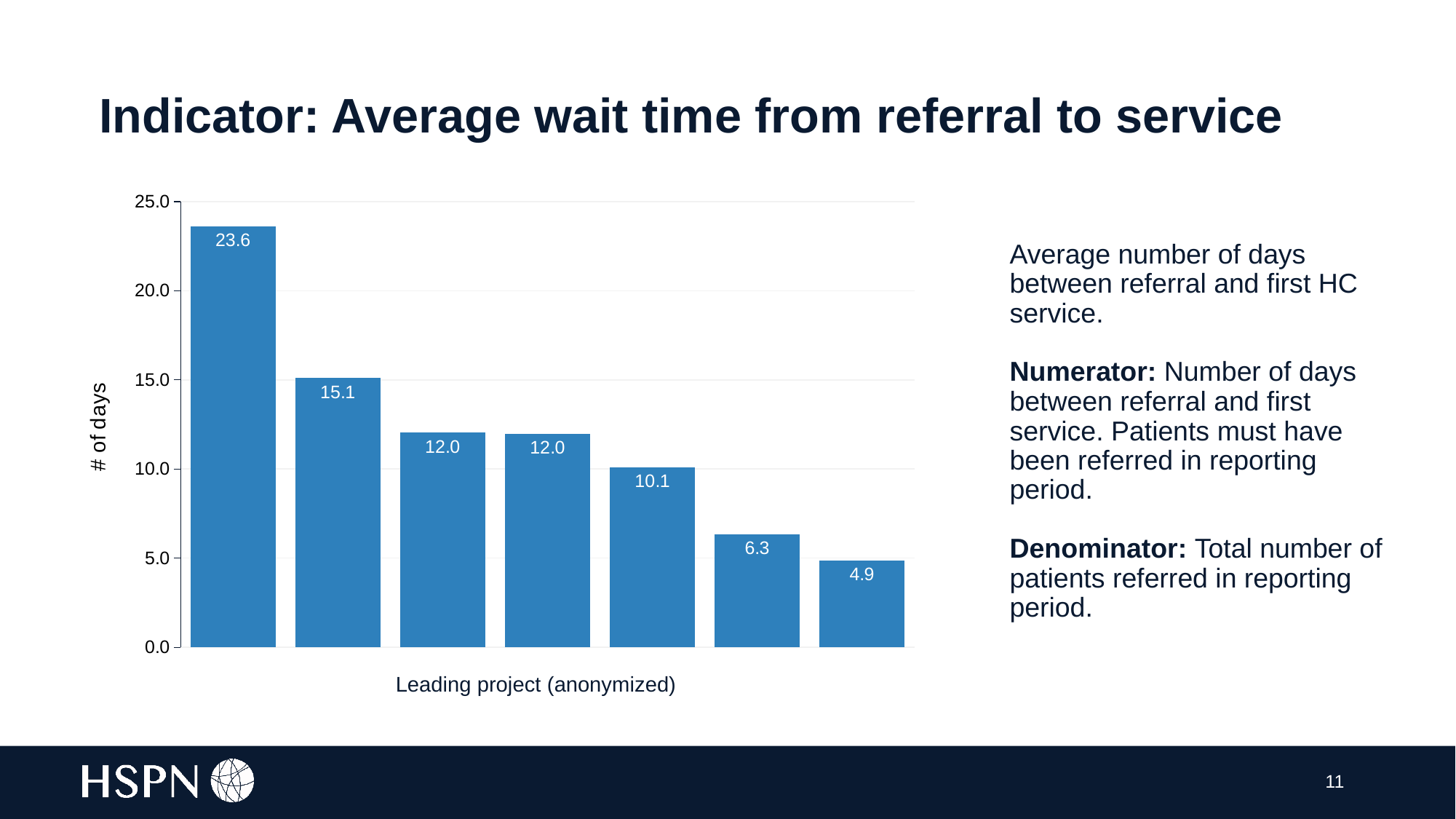
What is the difference between the second bar (15.1) and the third bar (12.0)? 3.1 What is the value shown on the second bar from the left? 15.1 What is the value shown on the fifth bar from the left? 10.1 What type of chart is shown on the slide? Bar chart What is the difference between the leftmost bar and the rightmost bar? 18.7 Is the value of the leftmost bar greater or less than 20.0? greater Do the bar values rise or fall from left to right across the chart? Fall What is the value shown on the sixth bar from the left? 6.3 Which is larger, the value of the second bar from the left or the value of the fifth bar from the left? The second bar from the left What is the value of the tallest bar in the chart? 23.6 How many bars are plotted in the chart? 7 What is the value of the shortest bar in the chart? 4.9